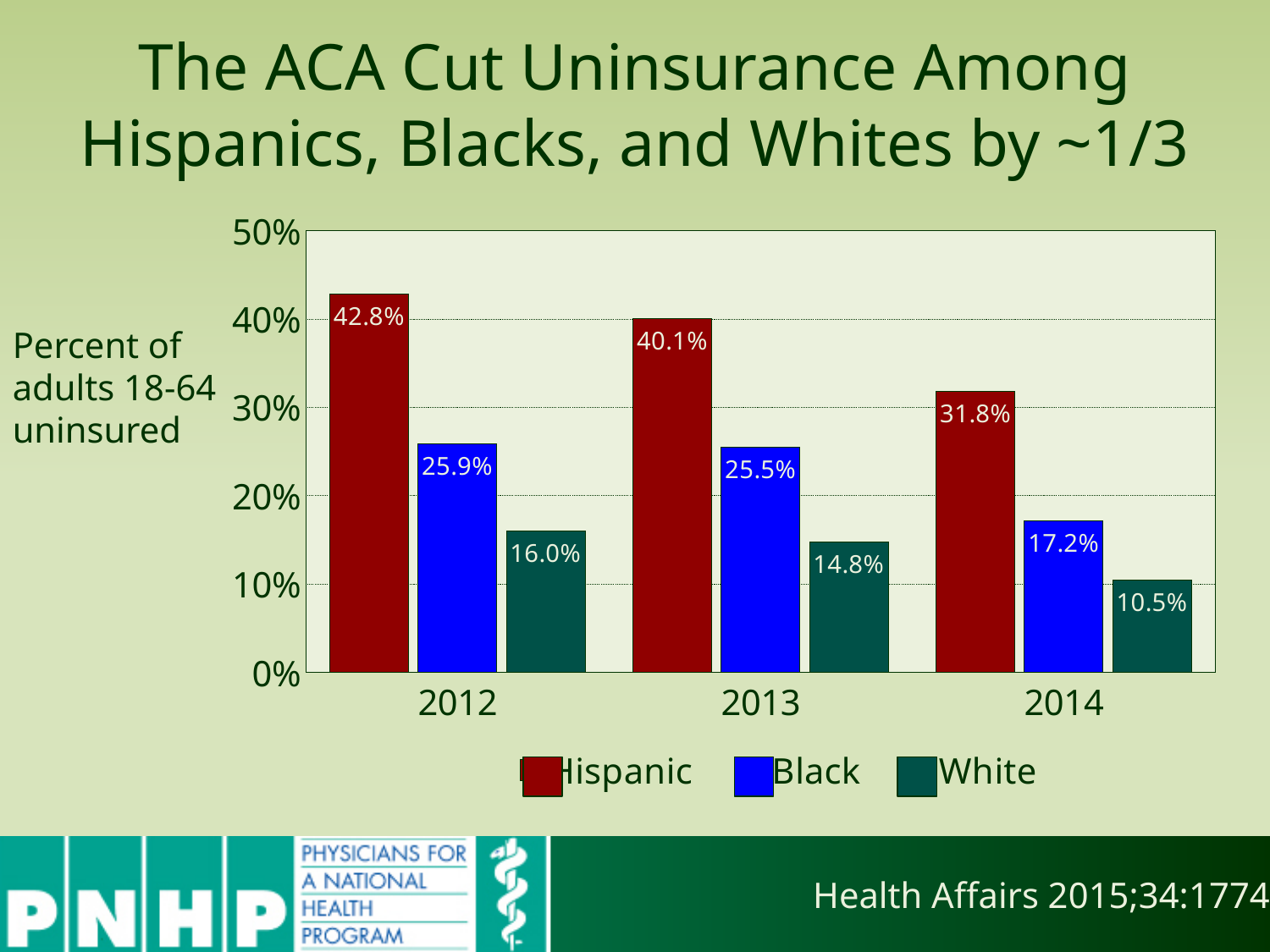
Is the Hispanic uninsured rate in 2013 greater or less than 30%? greater Which group has the lowest uninsured rate in 2014? White What is the difference between the Hispanic uninsured rate in 2012 and in 2014? 11.0% Does the uninsured rate for White adults rise or fall from 2012 to 2014? fall Which year has the highest uninsured rate for Hispanic adults? 2012 What is the uninsured rate for Black adults in 2013? 25.5% How many series does the legend list? 3 What is the uninsured rate for Hispanic adults in 2012? 42.8% How many years are shown on the x axis? 3 What kind of chart is shown on the slide? bar chart Which is larger: the Black uninsured rate in 2012 or the Black uninsured rate in 2014? 2012 What is the uninsured rate for White adults in 2014? 10.5%